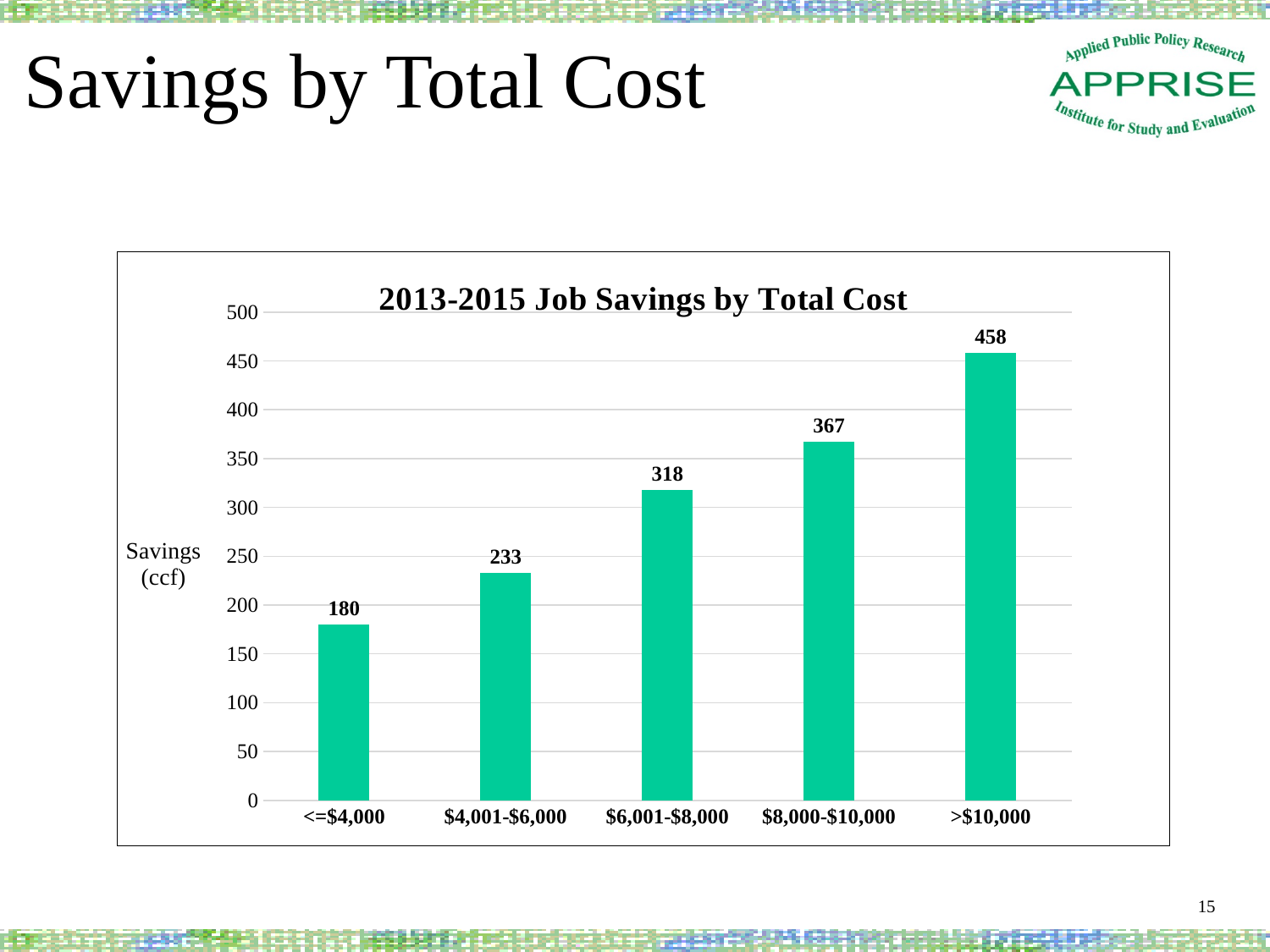
What is the savings value for the $6,001-$8,000 cost category? 318 Which cost category has the lowest savings? <=$4,000 What is the difference in savings between the $8,000-$10,000 and $4,001-$6,000 categories? 134 How many cost categories are shown in the chart? 5 Do the savings values rise or fall as total cost increases along the x axis? Rise Is the savings value for $8,000-$10,000 greater or less than 350? greater What kind of chart is shown on the slide? Bar chart Which has higher savings: $4,001-$6,000 or $6,001-$8,000? $6,001-$8,000 What is the difference in savings between the >$10,000 and <=$4,000 categories? 278 What is the savings value for the >$10,000 cost category? 458 Which cost category has the highest savings? >$10,000 What is the savings value for the <=$4,000 cost category? 180